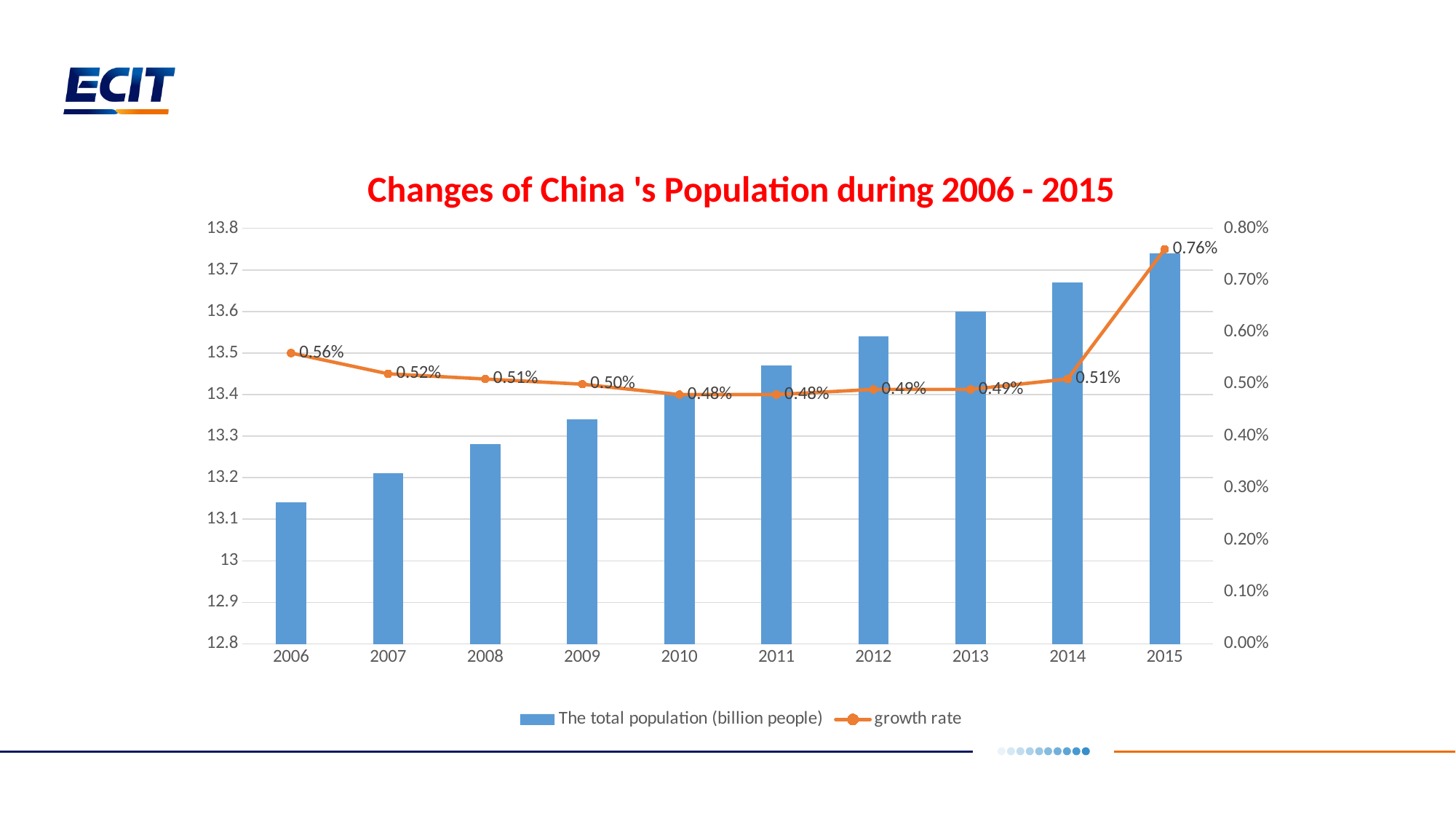
What is the difference between the growth rate in 2015 and the growth rate in 2014? 0.25% How many series does the legend list? 2 Which year has the highest total population? 2015 Is the total population for 2014 greater or less than 13.6 billion? greater What is the growth rate for 2015? 0.76% Which year has the lowest total population? 2006 What is the growth rate for 2009? 0.50% How many years are shown on the x axis? 10 Which year has the highest growth rate? 2015 Is the total population for 2008 greater or less than 13.3 billion? less What is the growth rate for 2006? 0.56% Is the growth rate in 2007 larger or smaller than the growth rate in 2010? larger